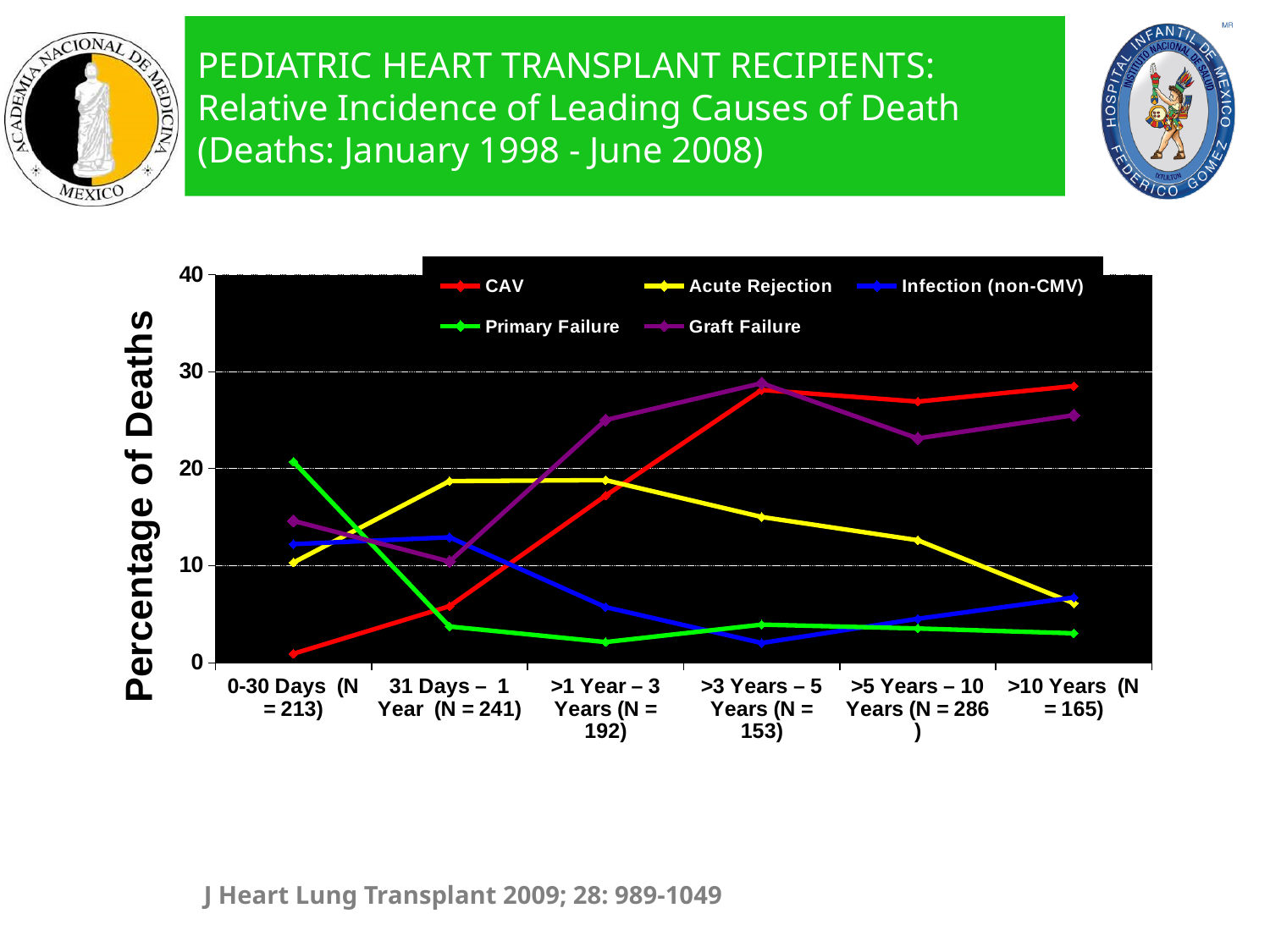
What kind of chart is shown on the slide? line chart What is the label on the y axis? Percentage of Deaths Which cause of death has the lowest percentage at 0-30 Days? CAV Is the value for CAV at 0-30 Days greater or less than 10? less How many time-period categories are shown on the x axis? 6 Which cause of death has the highest percentage at 0-30 Days? Primary Failure Is the value for Graft Failure at >1 Year – 3 Years greater or less than 20? greater Does the Primary Failure line rise or fall from 0-30 Days to 31 Days – 1 Year? fall Is the value for Primary Failure at 0-30 Days greater or less than 10? greater At >10 Years, which is larger: CAV or Primary Failure? CAV How many series does the legend list? 5 Does the CAV line rise or fall from 0-30 Days to >3 Years – 5 Years? rise